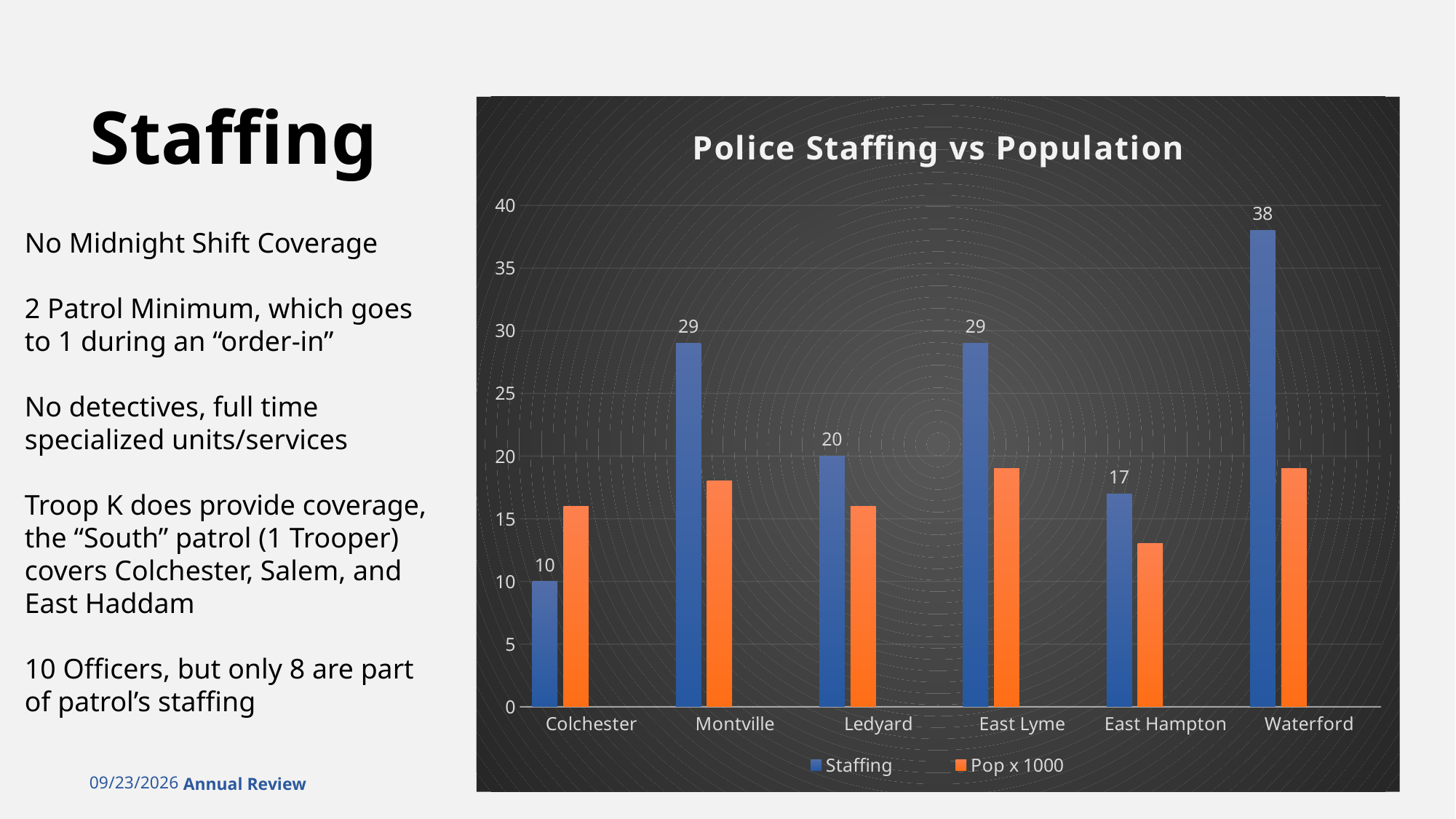
How many towns are shown on the x axis of the chart? 6 Is the Pop x 1000 value for East Hampton greater or less than 15? less What type of chart is shown on the slide? Bar chart What is the Staffing value for East Hampton? 17 Which has a larger Staffing value, Ledyard or East Hampton? Ledyard What is the Staffing value for Waterford? 38 Which town has the lowest Staffing value? Colchester What is the Staffing value for Colchester? 10 How many series does the chart legend list? 2 Is the Pop x 1000 value for Waterford greater or less than 15? greater What is the difference between the Staffing values for Waterford and Colchester? 28 Which town has the highest Staffing value? Waterford